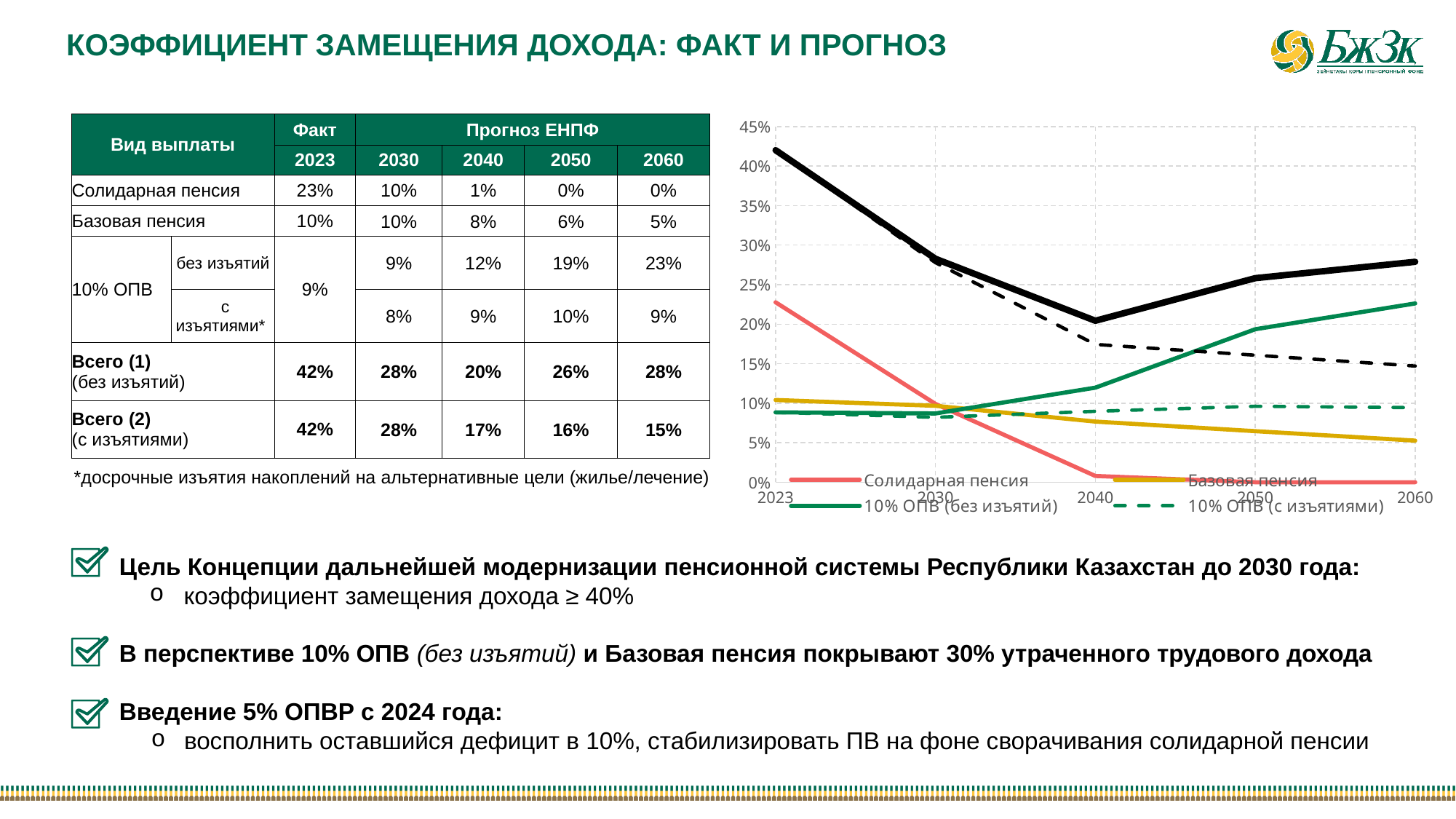
How many years are marked along the x axis of the chart? 5 How many series does the chart legend list? 4 What is the value of 10% ОПВ (без изъятий) in 2060? 23% What is the difference between 10% ОПВ (без изъятий) and 10% ОПВ (с изъятиями) in 2060? 14% Is the value of Солидарная пенсия in 2023 greater or less than 20%? greater Is the value of Базовая пенсия in 2060 greater or less than 10%? less In 2060, which is larger: 10% ОПВ (без изъятий) or Базовая пенсия? 10% ОПВ (без изъятий) Does the Солидарная пенсия line rise or fall from 2023 to 2060? fall What kind of chart is shown on the slide? line chart Does the 10% ОПВ (без изъятий) line rise or fall from 2023 to 2060? rise What is the value of Солидарная пенсия in 2023? 23% Which legend series has the highest value in 2023? Солидарная пенсия